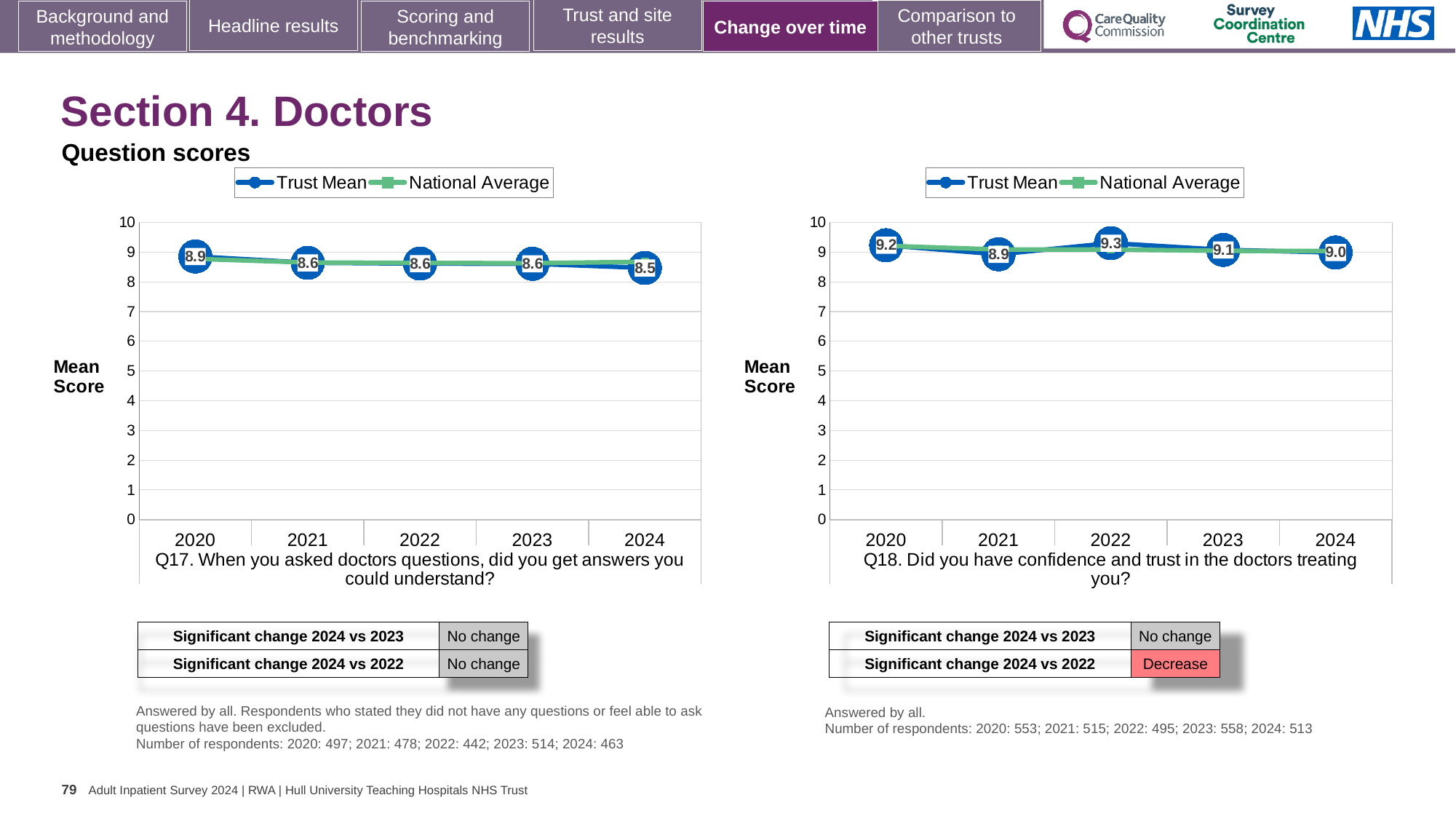
How many series does the legend of the Q18 chart (right) list? 2 How many years are plotted on the x axis of the Q17 chart (left)? 5 What type of chart is used for Q17 (left)? Line chart In the Q18 chart (right), which year has the highest Trust Mean score? 2022 In the Q18 chart (right), is the Trust Mean score higher in 2020 or in 2024? 2020 In the Q17 chart (left), which year has the lowest Trust Mean score? 2024 In the Q17 chart (left), what is the Trust Mean score for 2024? 8.5 In the Q17 chart (left), what is the difference between the Trust Mean scores for 2020 and 2024? 0.4 In the Q18 chart (right), what is the difference between the Trust Mean scores for 2022 and 2021? 0.4 In the Q17 chart (left), what is the Trust Mean score for 2020? 8.9 In the Q18 chart (right), what is the Trust Mean score for 2021? 8.9 In the Q18 chart (right), what is the Trust Mean score for 2022? 9.3